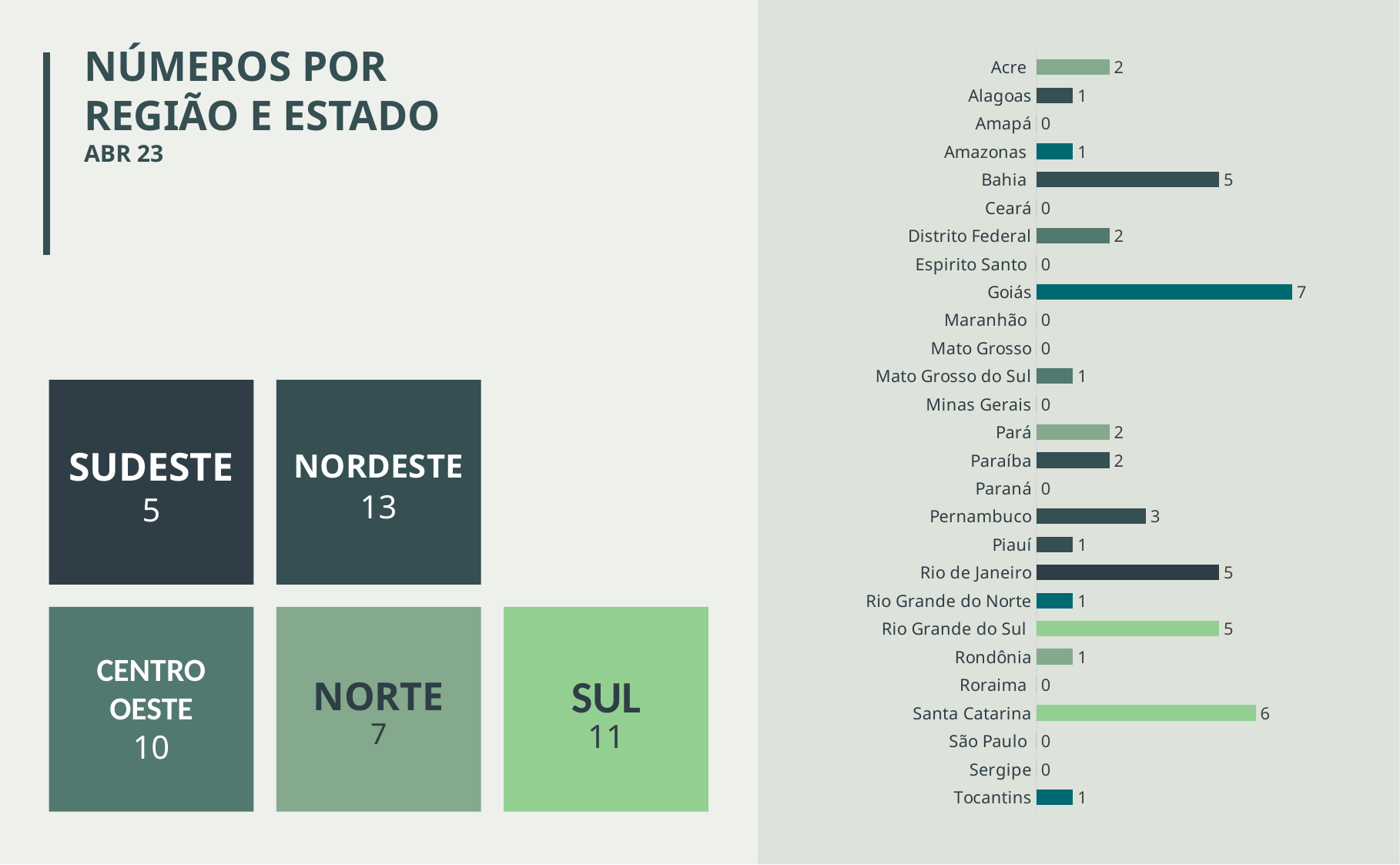
What is the value for Pernambuco in the bar chart? 3 What kind of chart is shown on the right of the slide? Bar chart What is the difference between the values for Bahia and Paraíba? 3 What is the value for Santa Catarina in the bar chart? 6 Which state has the highest value in the bar chart? Goiás What is the value for Bahia in the bar chart? 5 What is the title of the slide containing the bar chart? NÚMEROS POR REGIÃO E ESTADO What is the difference between the values for Goiás and Santa Catarina? 1 How many states in the bar chart have a value of 0? 10 Which has a larger value, Rio Grande do Sul or Pernambuco? Rio Grande do Sul How many states are listed in the bar chart? 27 What is the value for Goiás in the bar chart? 7